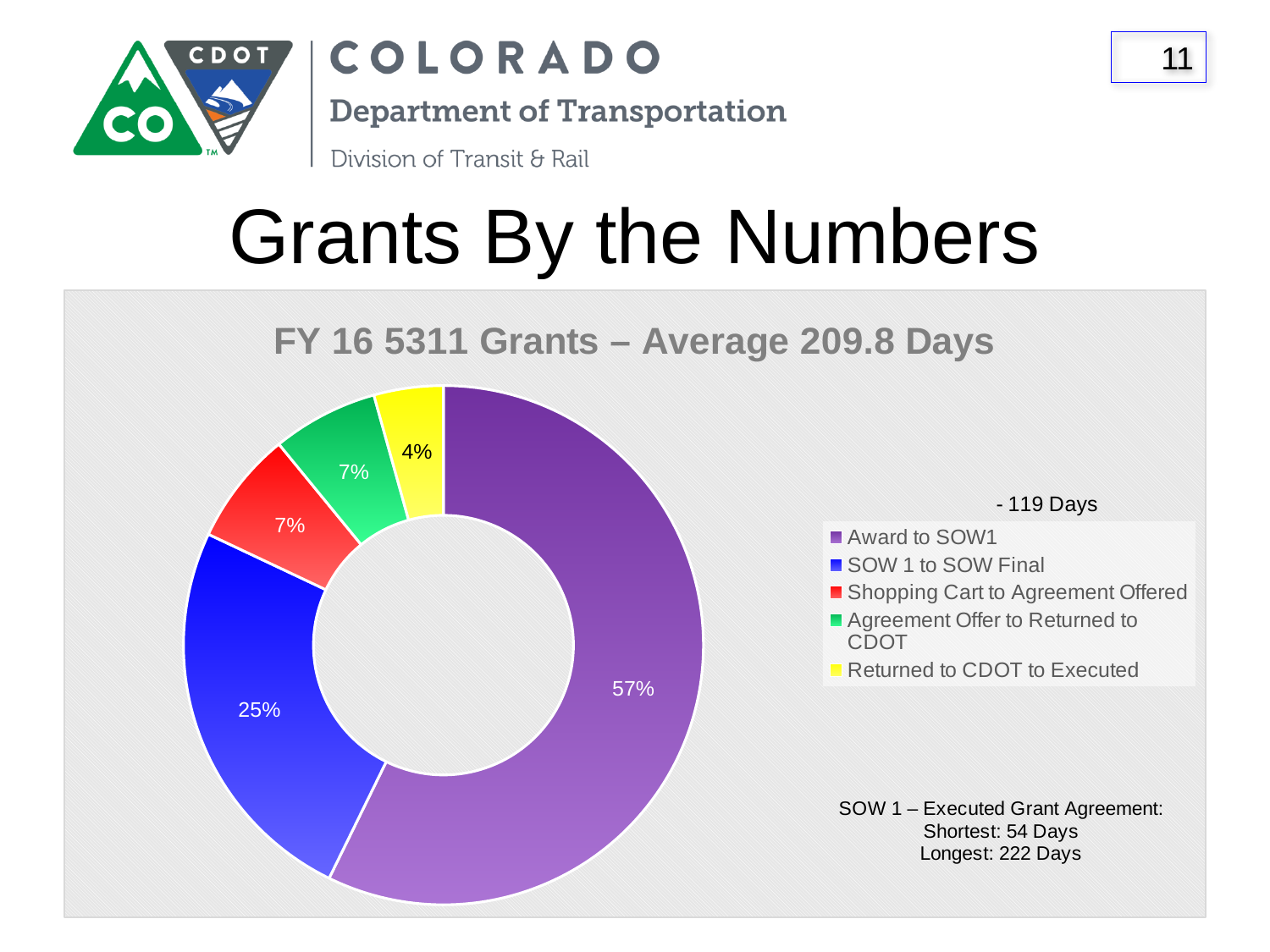
What percentage is shown for Returned to CDOT to Executed? 4% What is the difference in percentage points between Award to SOW1 and SOW 1 to SOW Final? 32 percentage points Which category has the largest share of the chart? Award to SOW1 What share of the chart does Award to SOW1 represent? 57% How many categories are shown in the chart? 5 Which is larger, the share for SOW 1 to SOW Final or the share for Agreement Offer to Returned to CDOT? SOW 1 to SOW Final What is the title of the chart? FY 16 5311 Grants – Average 209.8 Days What percentage is shown for Shopping Cart to Agreement Offered? 7% What colour is the slice for SOW 1 to SOW Final? Blue Which category has the smallest share of the chart? Returned to CDOT to Executed What percentage is shown for SOW 1 to SOW Final? 25% What kind of chart is shown on the slide? Doughnut chart